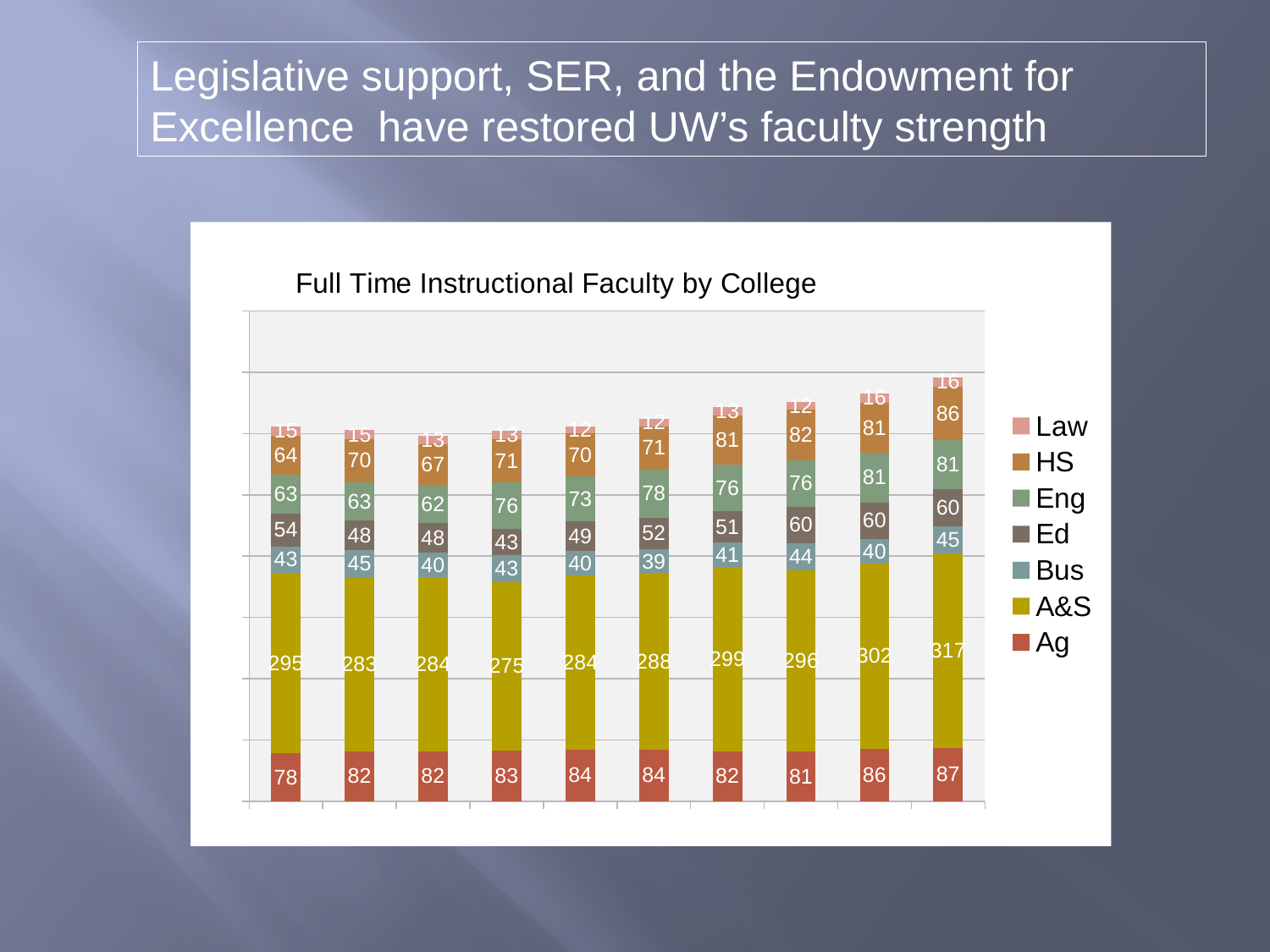
What is the A&S value in the rightmost bar? 317 Do the total heights of the stacked bars generally rise or fall from left to right? Rise Which is larger, the Ag value in the leftmost bar or the Ag value in the rightmost bar? The rightmost bar (87) What is the Ag value in the leftmost bar? 78 Which bar has the highest A&S value, and what is it? The rightmost bar, 317 How many series does the legend list? 7 What is the lowest A&S value shown across all bars? 275 How many bars are plotted in the chart? 10 What kind of chart is shown on the slide? Stacked bar chart What is the difference between the A&S value in the rightmost bar and the A&S value in the leftmost bar? 22 What is the HS value in the rightmost bar? 86 What is the title of the chart? Full Time Instructional Faculty by College